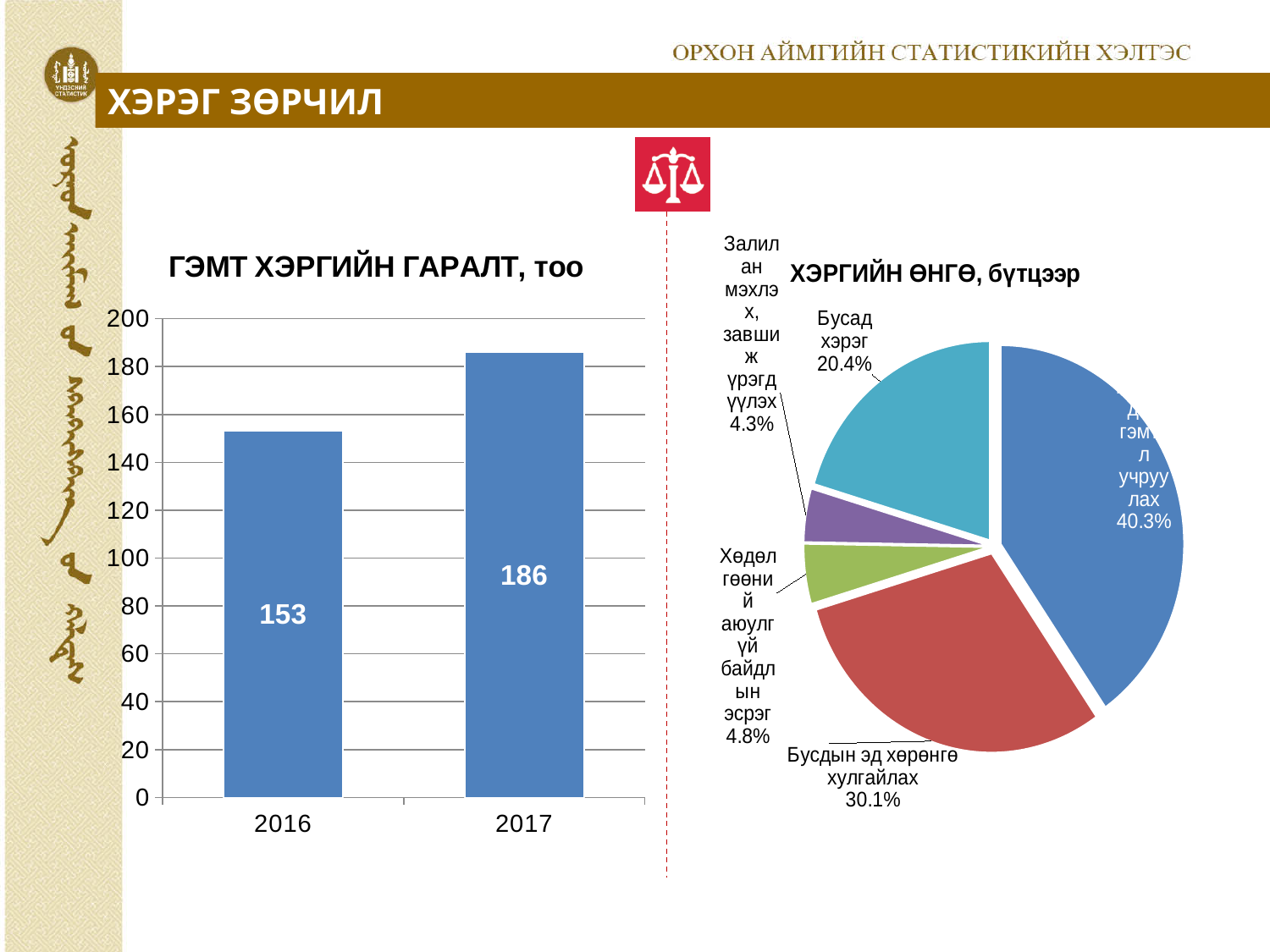
In the bar chart 'ГЭМТ ХЭРГИЙН ГАРАЛТ, тоо', which year has the higher value? 2017 In the bar chart 'ГЭМТ ХЭРГИЙН ГАРАЛТ, тоо', what is the value for 2016? 153 In the pie chart 'ХЭРГИЙН ӨНГӨ, бүтцээр', which is larger: 'Залилан мэхлэх, завшиж үрэгдүүлэх' or 'Хөдөлгөөний аюулгүй байдлын эсрэг'? Хөдөлгөөний аюулгүй байдлын эсрэг In the pie chart 'ХЭРГИЙН ӨНГӨ, бүтцээр', what share does 'Бусдын эд хөрөнгө хулгайлах' have? 30.1% In the pie chart 'ХЭРГИЙН ӨНГӨ, бүтцээр', what share does 'Бусад хэрэг' have? 20.4% In the bar chart 'ГЭМТ ХЭРГИЙН ГАРАЛТ, тоо', what is the value for 2017? 186 What kind of chart is 'ГЭМТ ХЭРГИЙН ГАРАЛТ, тоо'? bar chart In the bar chart 'ГЭМТ ХЭРГИЙН ГАРАЛТ, тоо', what is the difference between the 2017 and 2016 values? 33 In the bar chart 'ГЭМТ ХЭРГИЙН ГАРАЛТ, тоо', do the values rise or fall from 2016 to 2017? rise In the bar chart 'ГЭМТ ХЭРГИЙН ГАРАЛТ, тоо', how many years are shown? 2 In the pie chart 'ХЭРГИЙН ӨНГӨ, бүтцээр', how many slices are there? 5 In the pie chart 'ХЭРГИЙН ӨНГӨ, бүтцээр', what share does 'Хөдөлгөөний аюулгүй байдлын эсрэг' have? 4.8%